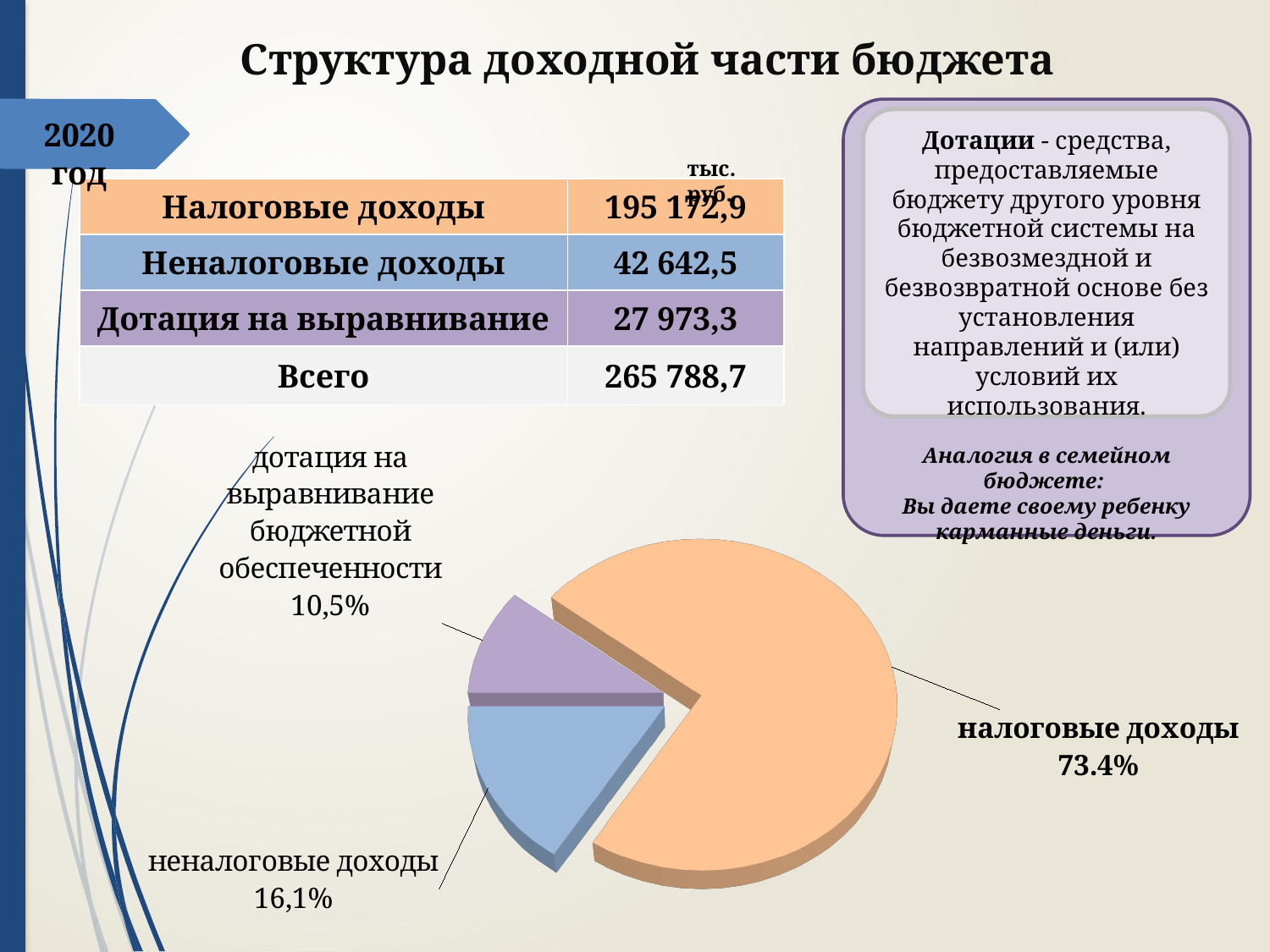
What share of the pie does неналоговые доходы take? 16,1% What share of the pie does налоговые доходы take? 73.4% What share of the pie does дотация на выравнивание бюджетной обеспеченности take? 10,5% What colour is the неналоговые доходы slice in the pie chart? blue Which slice of the pie chart is the smallest? дотация на выравнивание бюджетной обеспеченности How many slices does the pie chart have? 3 What kind of chart is shown on the slide? pie chart What colour is the налоговые доходы slice in the pie chart? orange Is the share for налоговые доходы in the pie chart greater or less than 50%? greater Which slice of the pie chart is the largest? налоговые доходы Which is larger in the pie chart: неналоговые доходы or дотация на выравнивание бюджетной обеспеченности? неналоговые доходы